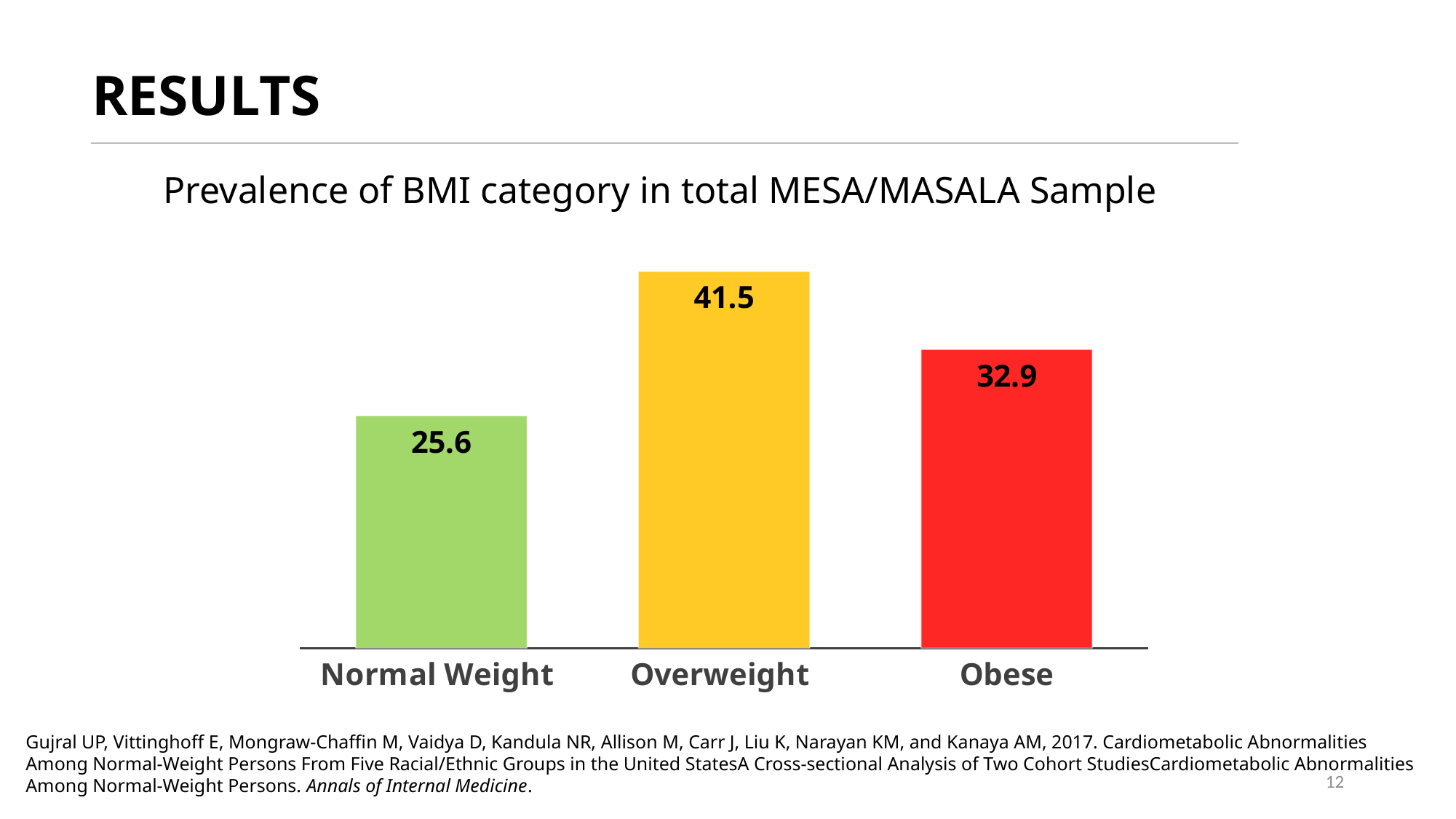
What is the value for Obese? 32.9 Which is larger, the value for Obese or the value for Normal Weight? Obese What is the difference between the Overweight and Obese values? 8.6 What is the value for Overweight? 41.5 Which BMI category has the lowest prevalence? Normal Weight What is the title of the chart? Prevalence of BMI category in total MESA/MASALA Sample What is the difference between the Obese and Normal Weight values? 7.3 Which BMI category has the highest prevalence? Overweight What kind of chart is shown on the slide? Bar chart How many BMI categories are shown in the chart? 3 What is the difference between the Overweight and Normal Weight values? 15.9 What is the value for Normal Weight? 25.6